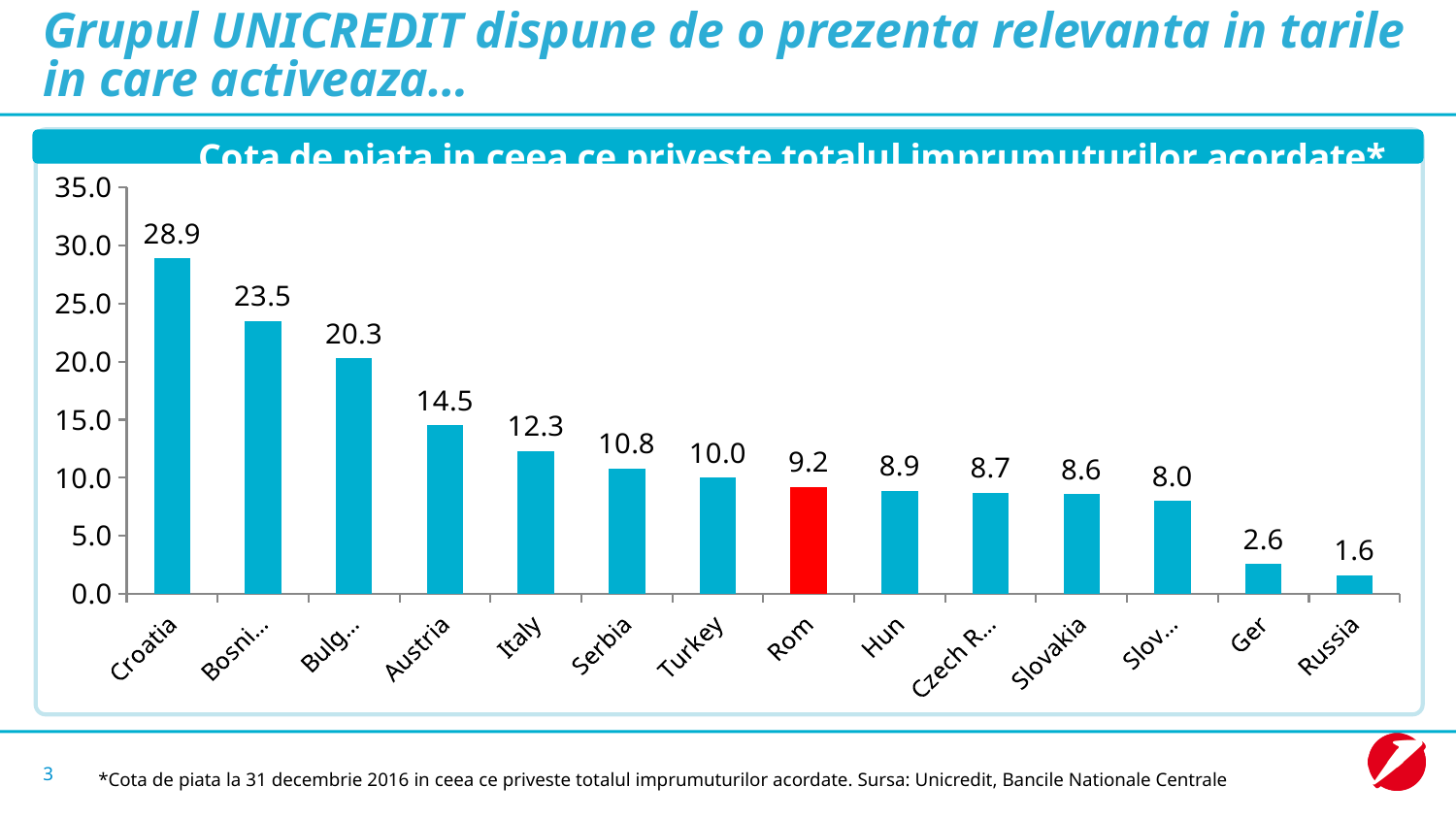
Which is larger, the value for Turkey or the value for Slovakia? Turkey What is the value for Austria? 14.5 What is the difference between the values for Croatia and Austria? 14.4 What is the difference between the values for Italy and Serbia? 1.5 Do the values generally rise or fall from left to right along the x axis? Fall Which category has the lowest value? Russia What is the value for the bar labelled Rom? 9.2 How many categories are shown on the x axis? 14 Which bar is coloured red instead of blue? Rom What is the value for Croatia? 28.9 Which category has the highest value? Croatia What kind of chart is shown? Bar chart